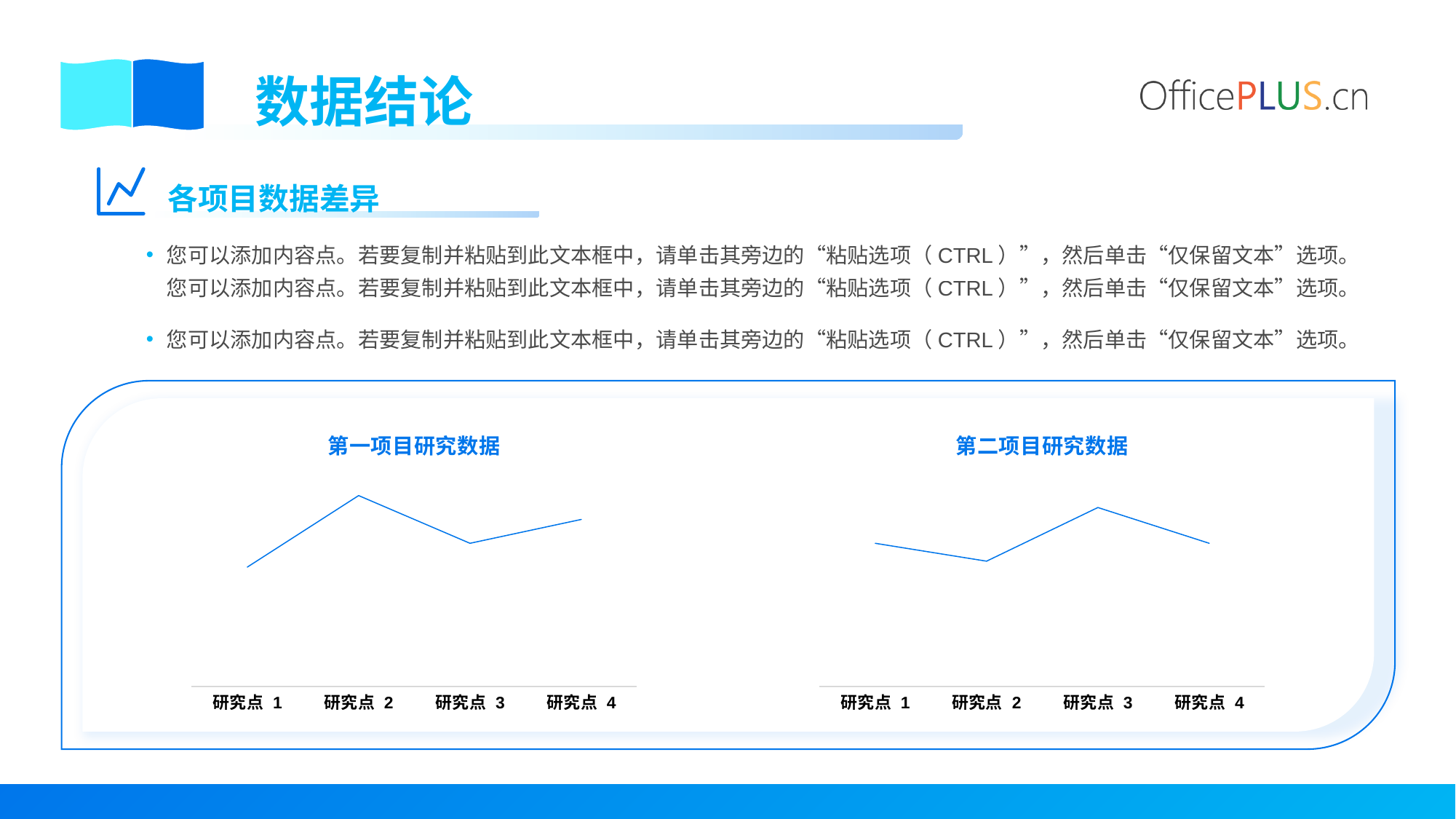
In the chart titled 第一项目研究数据, does the line rise or fall from 研究点 1 to 研究点 2? rise What kind of chart is the chart titled 第一项目研究数据? line chart In the chart titled 第二项目研究数据, which is larger, the value for 研究点 1 or 研究点 3? 研究点 3 What kind of chart is the chart titled 第二项目研究数据? line chart In the chart titled 第二项目研究数据, which category has the lowest value? 研究点 2 In the chart titled 第一项目研究数据, which is larger, the value for 研究点 3 or 研究点 4? 研究点 4 In the chart titled 第二项目研究数据, which category has the highest value? 研究点 3 How many data points are plotted in the chart titled 第一项目研究数据? 4 In the chart titled 第二项目研究数据, does the line rise or fall from 研究点 3 to 研究点 4? fall How many categories are shown on the x axis of the chart titled 第二项目研究数据? 4 In the chart titled 第一项目研究数据, which category has the lowest value? 研究点 1 In the chart titled 第一项目研究数据, which category has the highest value? 研究点 2